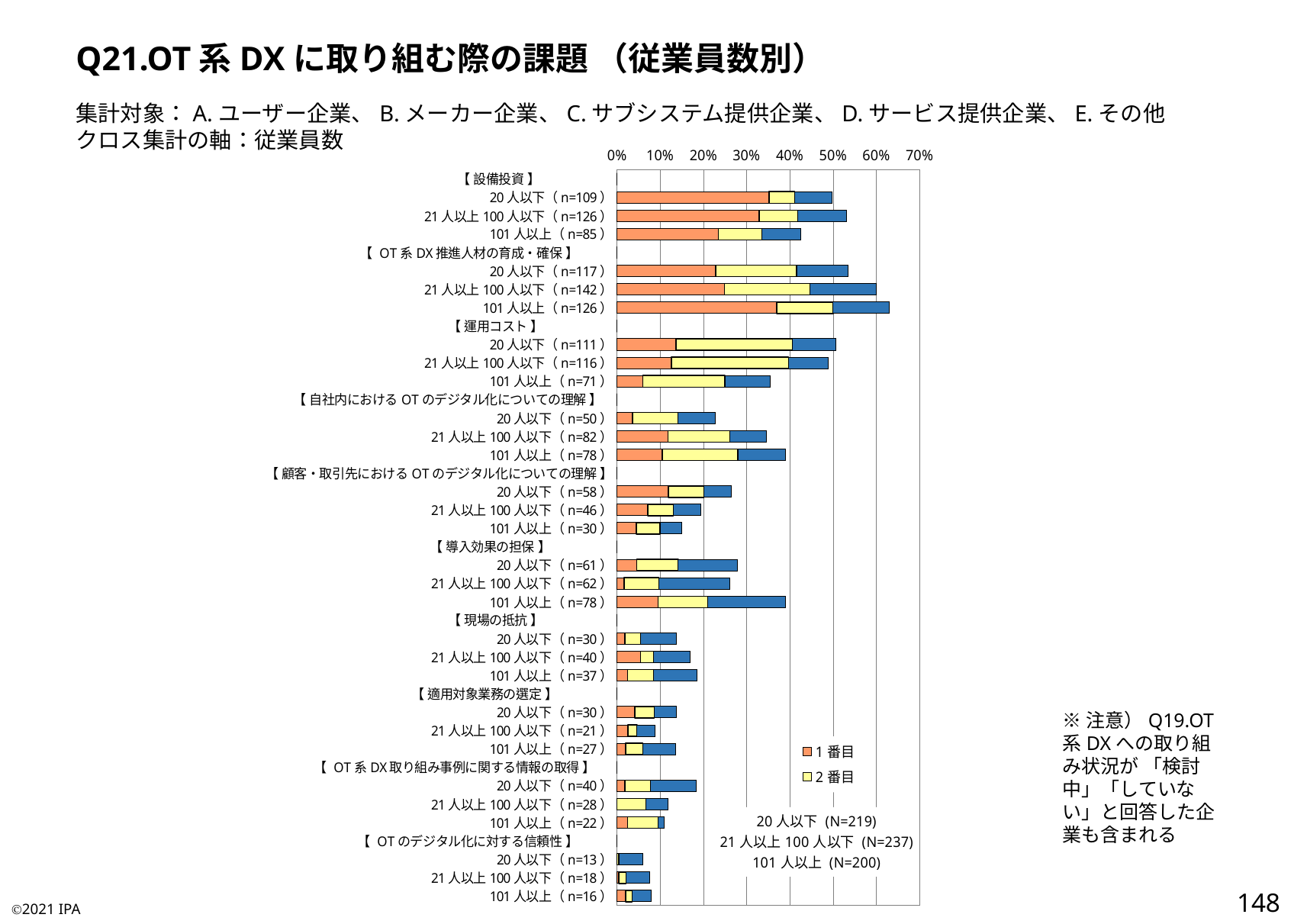
Which bar is the longest overall on the chart? OT系DX推進人材の育成・確保, 101人以上 (n=126) Within 設備投資, which has the longer total bar: 20人以下 (n=109) or 101人以上 (n=85)? 20人以下 (n=109) How many challenge categories (bracketed group headings) are shown on the chart? 10 Is the total bar for 設備投資, 21人以上100人以下 (n=126) greater or less than 50%? greater Is the total bar for 顧客・取引先におけるOTのデジタル化についての理解, 101人以上 (n=30) greater or less than 20%? less Which challenge category has the shortest bars overall? OTのデジタル化に対する信頼性 Within 導入効果の担保, which has the longer total bar: 21人以上100人以下 (n=62) or 101人以上 (n=78)? 101人以上 (n=78) Is the total bar for OT系DX推進人材の育成・確保, 101人以上 (n=126) greater or less than 60%? greater What are the two series names shown in the legend? 1番目, 2番目 What is the highest value shown on the percentage axis? 70% What kind of chart is shown on the slide? Stacked horizontal bar chart How many series does the legend list? 2